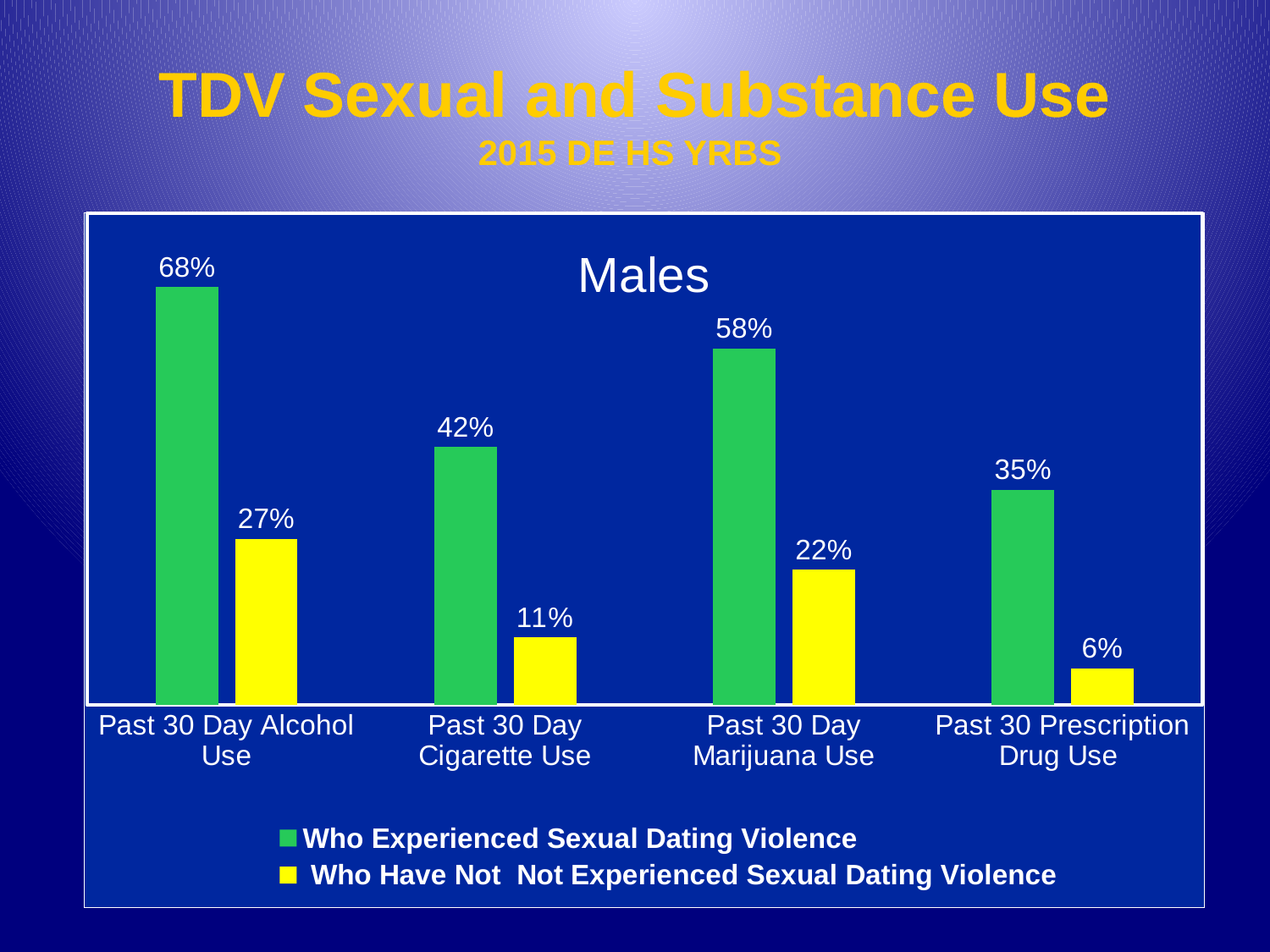
What is the value for Past 30 Day Cigarette Use among males who have not experienced sexual dating violence? 11% What is the title shown inside the chart area? Males What kind of chart is shown on the slide? Bar chart Which is larger: Past 30 Day Cigarette Use for males who experienced sexual dating violence, or Past 30 Day Alcohol Use for males who have not? Past 30 Day Cigarette Use for males who experienced sexual dating violence Which category has the highest value for males who experienced sexual dating violence? Past 30 Day Alcohol Use Which category has the lowest value for males who have not experienced sexual dating violence? Past 30 Prescription Drug Use What is the value for Past 30 Prescription Drug Use among males who experienced sexual dating violence? 35% How many series does the legend list? 2 Which colour represents males who experienced sexual dating violence? Green What is the value for Past 30 Day Alcohol Use among males who experienced sexual dating violence? 68% What is the difference between the two series for Past 30 Day Marijuana Use? 36% How many categories are shown on the x axis? 4